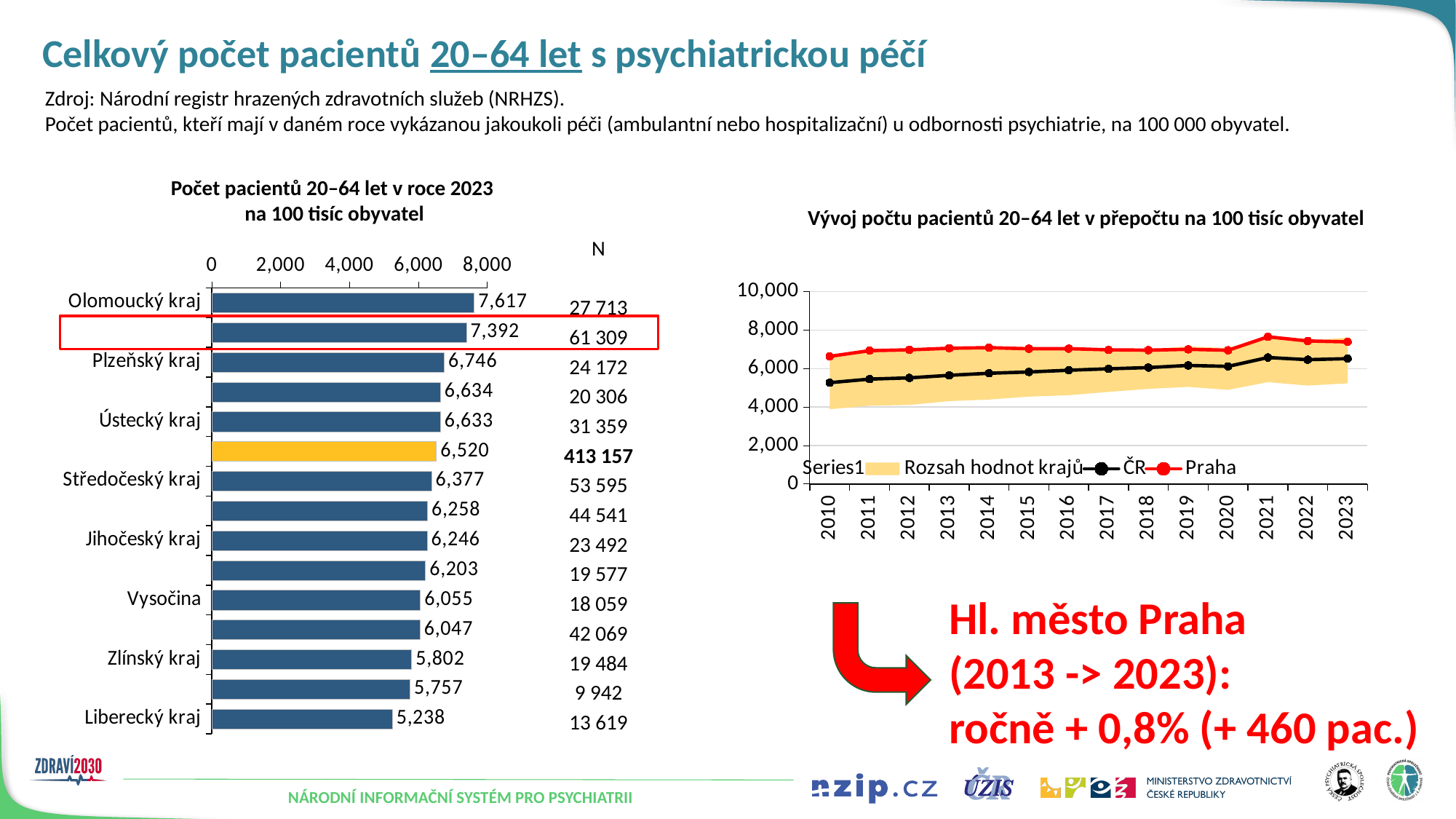
What kind of chart is 'Počet pacientů 20–64 let v roce 2023 na 100 tisíc obyvatel'? Bar chart In the bar chart 'Počet pacientů 20–64 let v roce 2023 na 100 tisíc obyvatel', what is the difference between the values for Olomoucký kraj and Liberecký kraj? 2,379 In the bar chart 'Počet pacientů 20–64 let v roce 2023 na 100 tisíc obyvatel', what is the value for Liberecký kraj? 5,238 In the bar chart 'Počet pacientů 20–64 let v roce 2023 na 100 tisíc obyvatel', which has the larger value, Plzeňský kraj or Zlínský kraj? Plzeňský kraj How many bars are plotted in the bar chart 'Počet pacientů 20–64 let v roce 2023 na 100 tisíc obyvatel'? 15 How many entries does the legend of the chart 'Vývoj počtu pacientů 20–64 let v přepočtu na 100 tisíc obyvatel' list? 4 In the chart 'Vývoj počtu pacientů 20–64 let v přepočtu na 100 tisíc obyvatel', what colour is the Praha line? Red In the bar chart 'Počet pacientů 20–64 let v roce 2023 na 100 tisíc obyvatel', which region has the lowest value? Liberecký kraj In the bar chart 'Počet pacientů 20–64 let v roce 2023 na 100 tisíc obyvatel', what is the value for Olomoucký kraj? 7,617 In the bar chart 'Počet pacientů 20–64 let v roce 2023 na 100 tisíc obyvatel', which region has the highest value? Olomoucký kraj In the chart 'Vývoj počtu pacientů 20–64 let v přepočtu na 100 tisíc obyvatel', is the value for ČR in 2010 greater or less than 6,000? less In the chart 'Vývoj počtu pacientů 20–64 let v přepočtu na 100 tisíc obyvatel', does the ČR line rise or fall from 2010 to 2023? rise